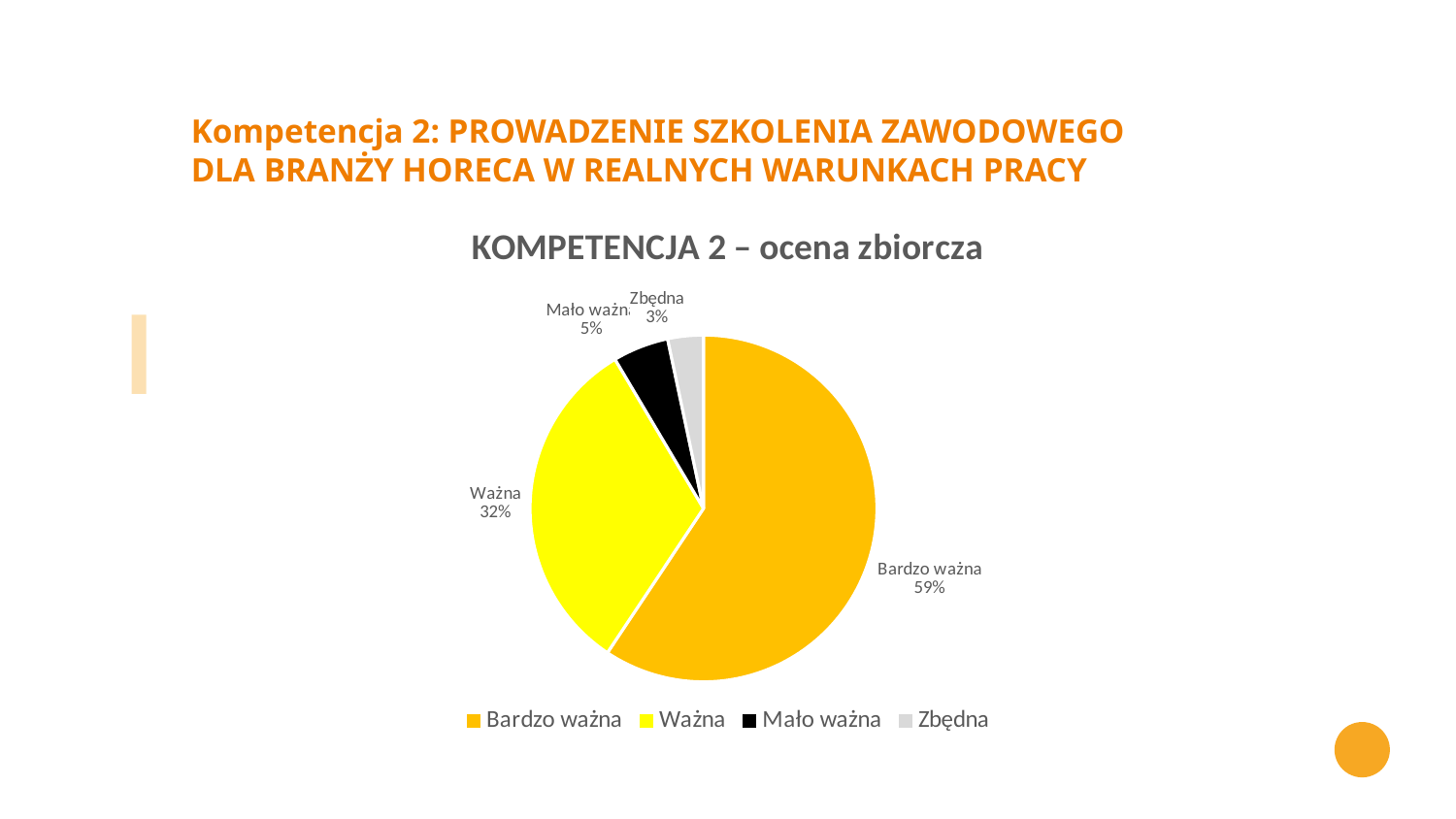
What share of the pie is labelled "Bardzo ważna"? 59% Which category has the largest slice of the pie? Bardzo ważna Which is larger, the share for "Mało ważna" or the share for "Zbędna"? Mało ważna What share of the pie is labelled "Ważna"? 32% What share of the pie is labelled "Mało ważna"? 5% How many categories does the legend list? 4 Which category has the smallest slice of the pie? Zbędna What is the difference in percentage points between "Bardzo ważna" and "Ważna"? 27 What colour is the "Ważna" slice? yellow What kind of chart is shown on the slide? pie chart What is the chart's title? KOMPETENCJA 2 – ocena zbiorcza